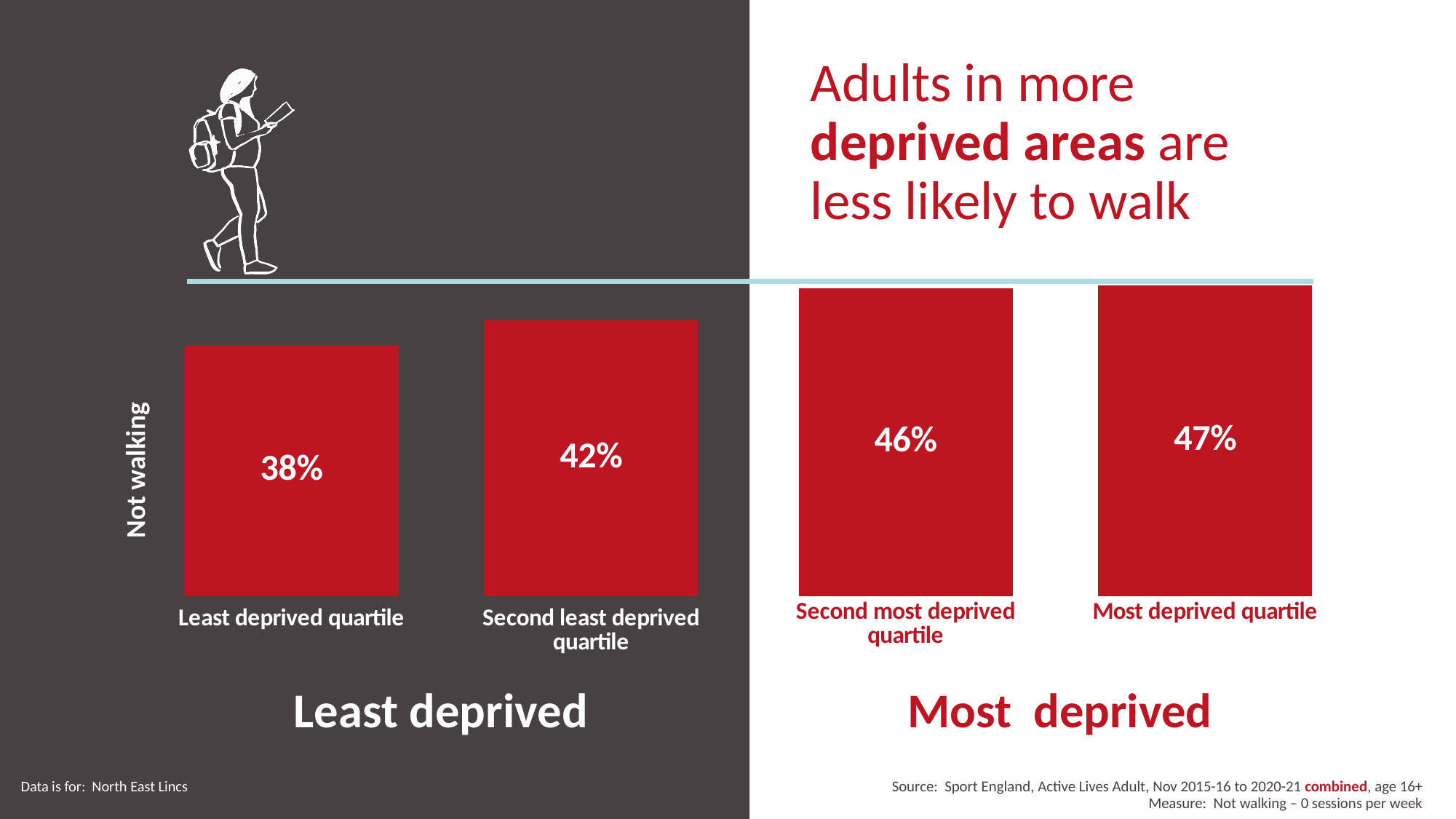
Which is larger, the value for the second least deprived quartile or the second most deprived quartile? Second most deprived quartile What is the difference between the most deprived quartile and the least deprived quartile? 9% How many quartile categories are shown in the chart? 4 Which quartile has the highest share of adults not walking? Most deprived quartile Which quartile has the lowest share of adults not walking? Least deprived quartile What percentage of adults in the least deprived quartile are not walking? 38% What kind of chart is shown on the slide? Bar chart What is the value for the second least deprived quartile? 42% What is the difference between the second most deprived quartile and the second least deprived quartile? 4% Do the values rise or fall moving from the least deprived quartile to the most deprived quartile? Rise What is the value for the second most deprived quartile? 46% What is the value for the most deprived quartile? 47%